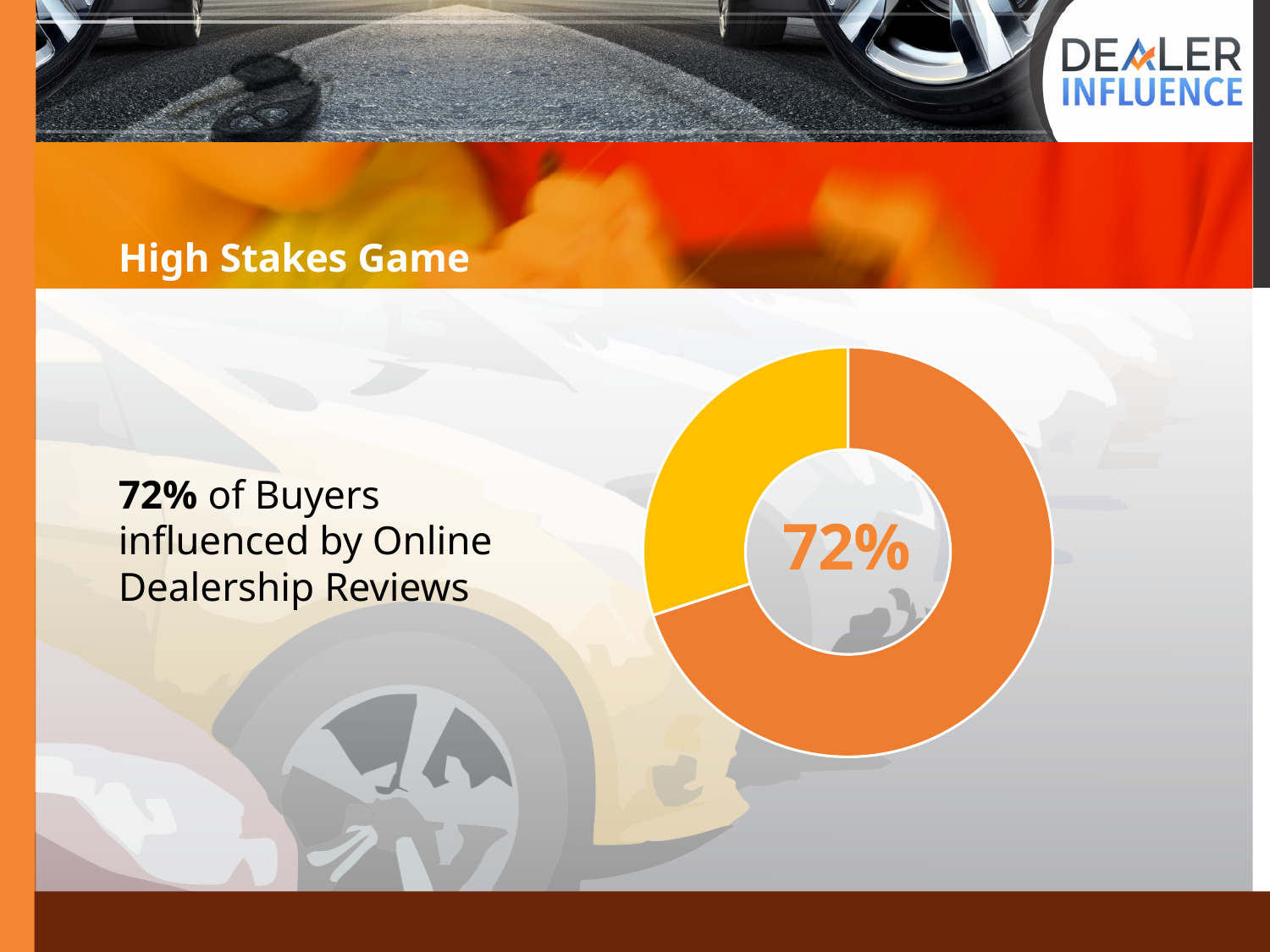
According to the text next to the chart, what percentage of buyers are influenced by online dealership reviews? 72% Which slice of the doughnut chart is larger, the orange one or the yellow one? Orange How many slices does the doughnut chart have? 2 Is the orange slice of the doughnut chart greater or less than 50% of the whole? greater What colour is the largest slice of the doughnut chart? Orange Is the yellow slice of the doughnut chart greater or less than 50% of the whole? less Which slice of the doughnut chart is the smallest? The yellow slice What value is printed in the centre of the doughnut chart? 72% What kind of chart is shown on the slide? Doughnut chart